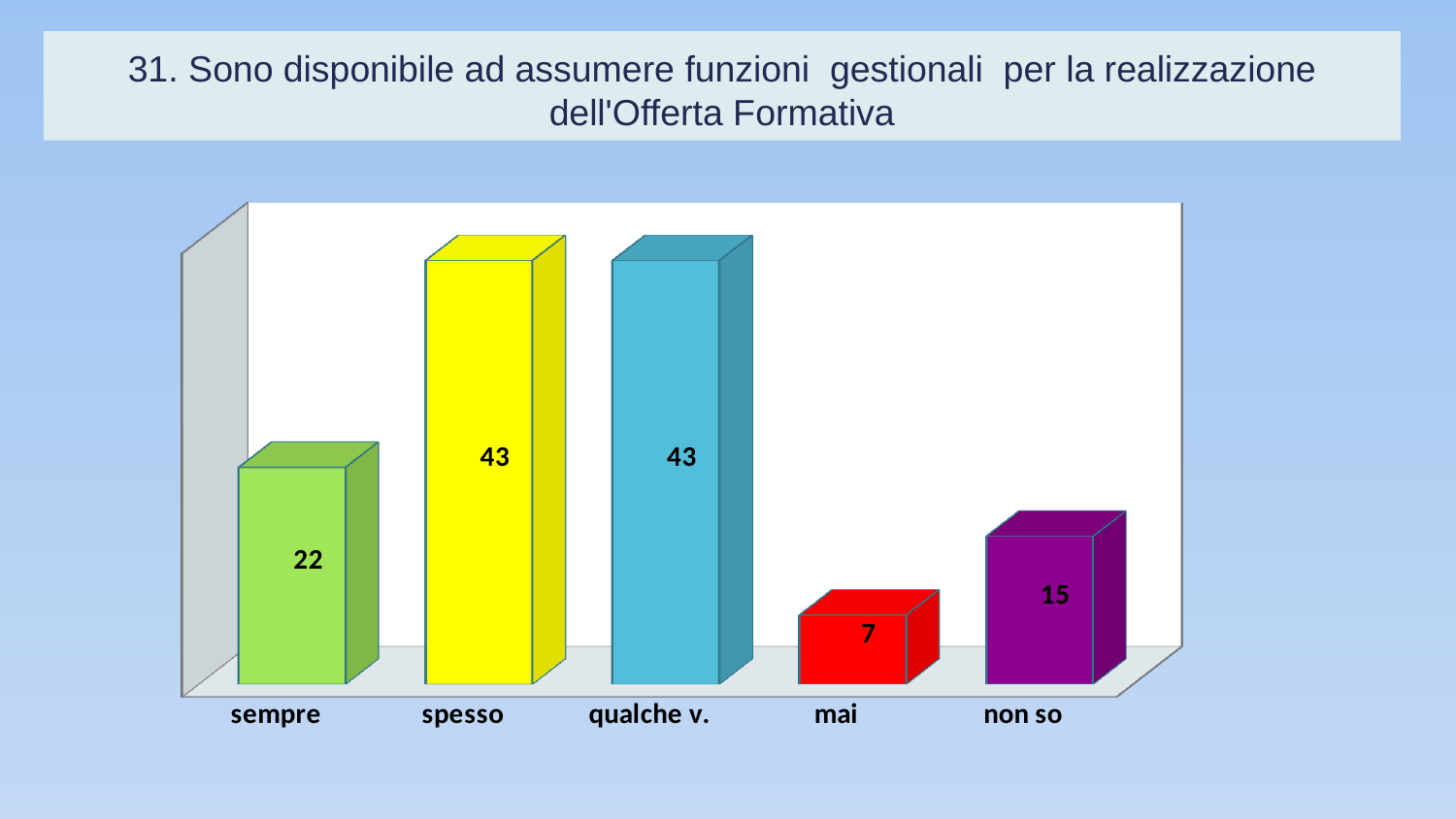
What is the value for "spesso"? 43 What is the difference between the values for "non so" and "mai"? 8 What is the difference between the values for "spesso" and "sempre"? 21 What is the value for "mai"? 7 Which two categories share the highest value? spesso and qualche v. What is the value for "non so"? 15 Which category has the lowest value? mai How many categories are shown on the x axis? 5 What colour is the bar for "mai"? red What is the value for "sempre"? 22 What kind of chart is shown on the slide? bar chart Which is larger, the value for "sempre" or the value for "non so"? sempre